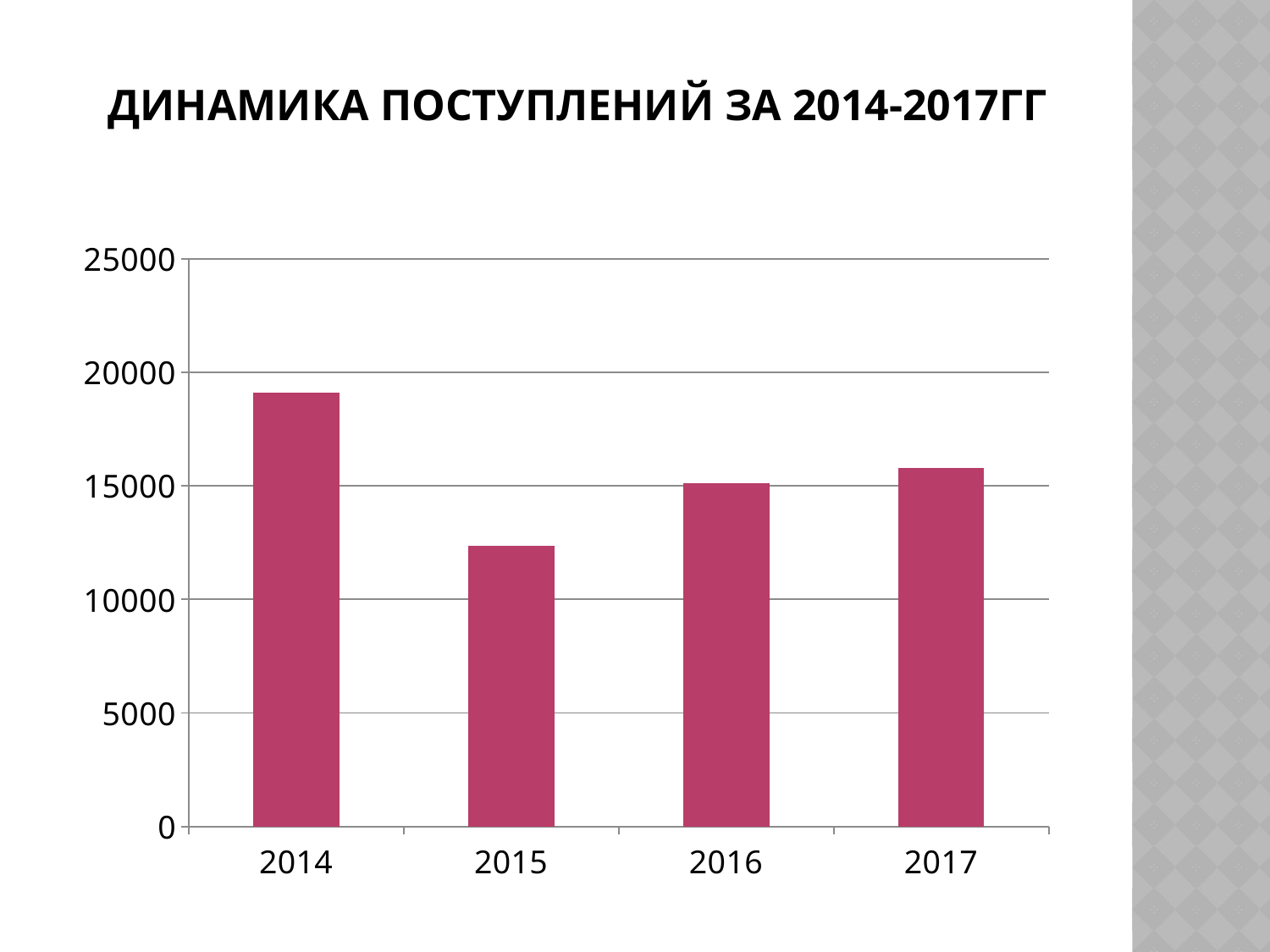
Is the value for 2015 greater or less than 15000? less What is the title of the chart? ДИНАМИКА ПОСТУПЛЕНИЙ ЗА 2014-2017ГГ Is the value for 2014 greater or less than 15000? greater Does the value fall or rise from 2014 to 2015? fall Is the value for 2017 greater or less than 20000? less Which is larger, the value for 2014 or the value for 2015? 2014 What kind of chart is shown on the slide? bar chart How many years are shown on the x axis of the chart? 4 Which year has the highest value in the chart? 2014 Which year has the lowest value in the chart? 2015